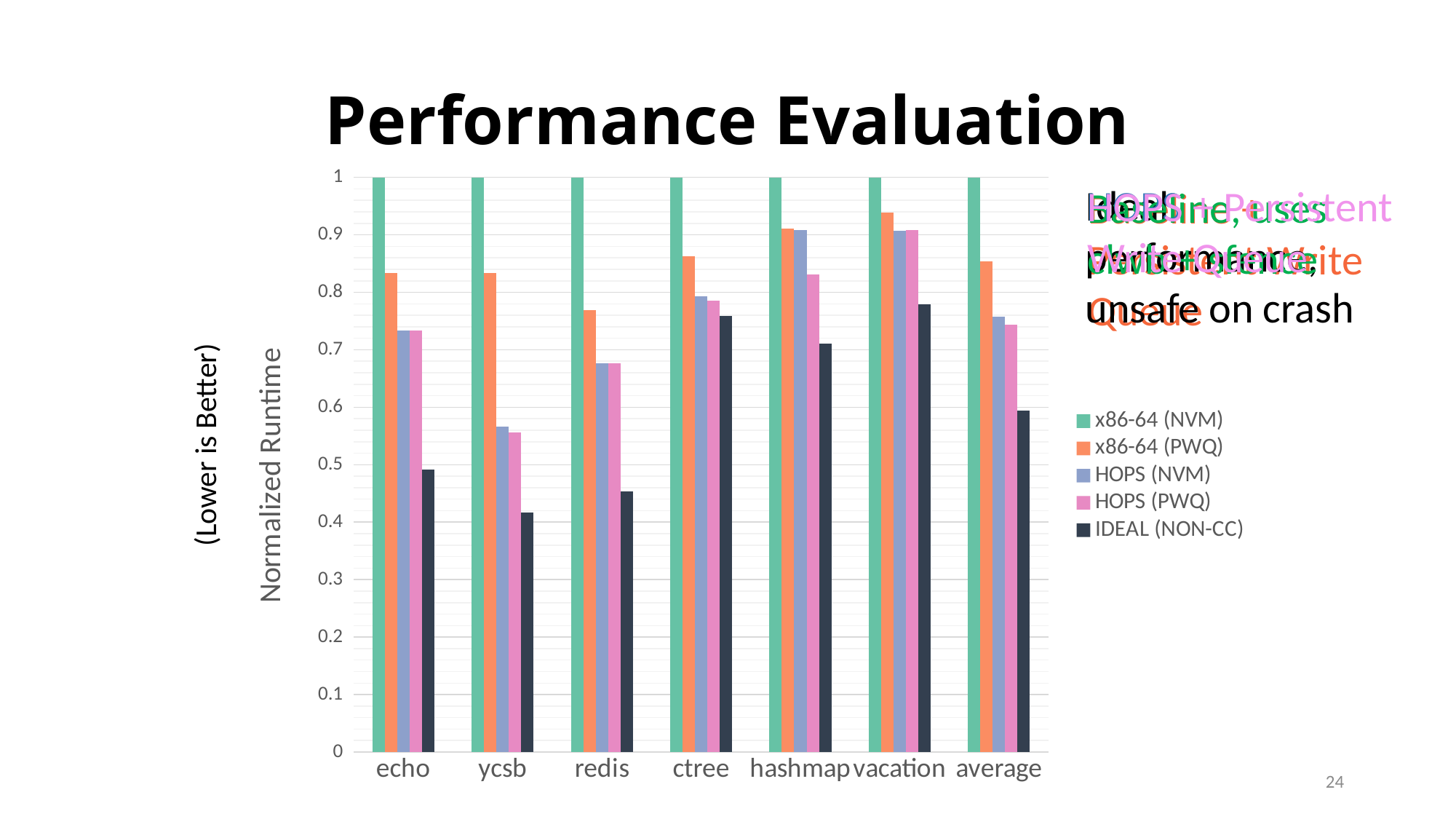
What kind of chart is shown on the slide? bar chart Is the value of HOPS (NVM) for ycsb greater or less than 0.6? less For which category is the IDEAL (NON-CC) bar lowest? ycsb Is the value of x86-64 (PWQ) for vacation greater or less than 0.9? greater For which category is the x86-64 (PWQ) bar highest? vacation Is the value of IDEAL (NON-CC) for ycsb greater or less than 0.5? less Which is larger, the HOPS (PWQ) value for echo or for ycsb? echo What is the value of x86-64 (NVM) for redis? 1 How many categories are shown along the x axis of the chart? 7 How many series does the chart's legend list? 5 What is the label of the chart's vertical axis? Normalized Runtime